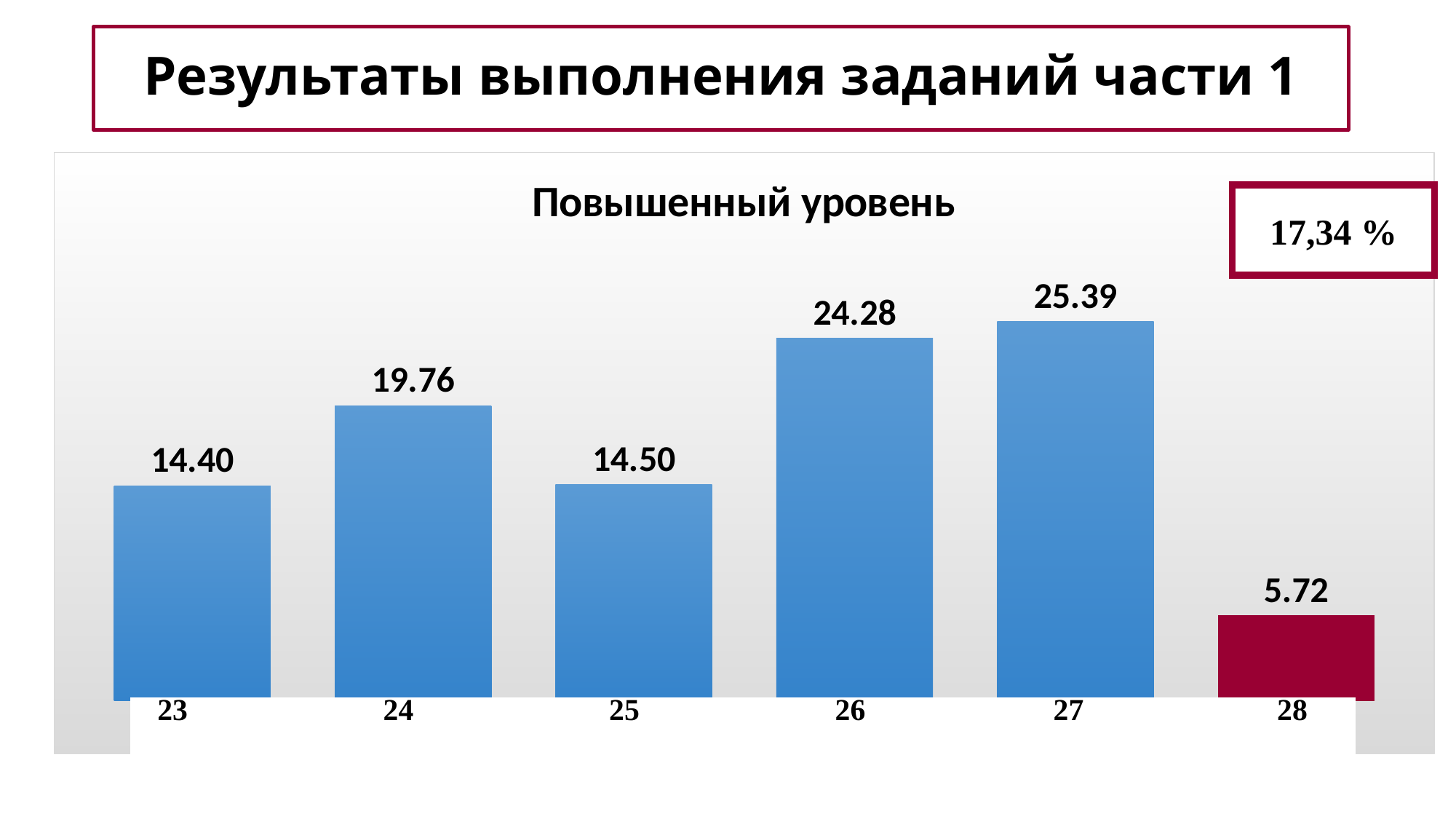
What is the value for category 28? 5.72 What is the title of the chart? Повышенный уровень Which category has the highest value? 27 What is the difference between the values for categories 24 and 23? 5.36 What is the value for category 26? 24.28 Which is larger, the value for category 24 or the value for category 25? 24 Which category's bar is coloured differently (dark red) from the others? 28 What is the difference between the values for categories 27 and 26? 1.11 How many categories are shown on the chart? 6 What kind of chart is shown on the slide? bar chart What is the value for category 23? 14.40 Which category has the lowest value? 28